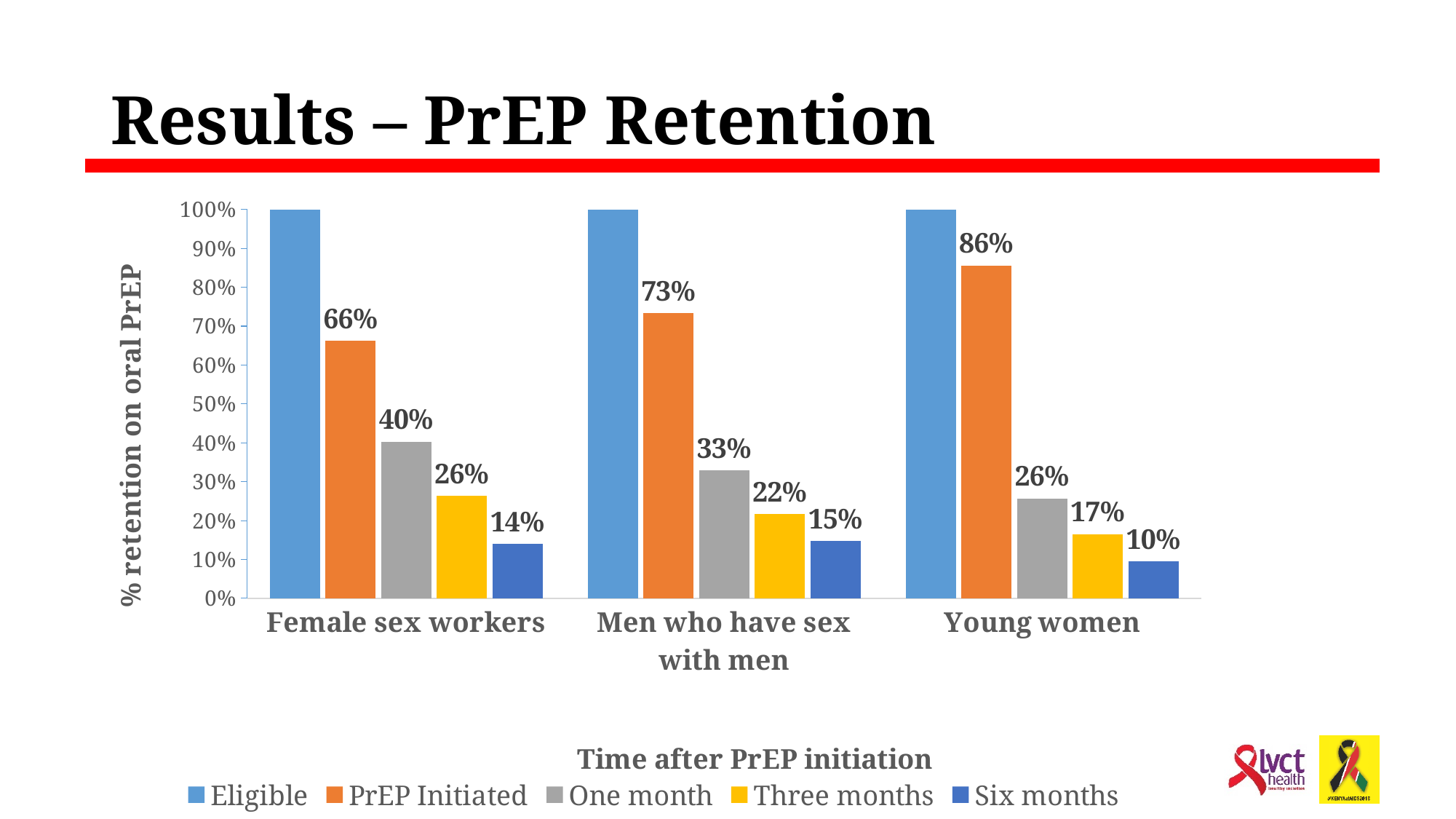
How many series does the legend list? 5 Which is larger for Men who have sex with men: the Three months value or the Six months value? Three months What is the Three months value for Young women? 17% Which population group has the highest PrEP Initiated value? Young women How many population groups are shown on the x axis? 3 Which population group has the lowest Six months retention value? Young women What is the difference between the PrEP Initiated value and the One month value for Female sex workers? 26% What is the One month value for Men who have sex with men? 33% What kind of chart is shown on the slide? Bar chart What is the Six months retention value for Young women? 10% Is the Eligible value for Young women greater or less than 90%? greater What is the PrEP Initiated value for Female sex workers? 66%